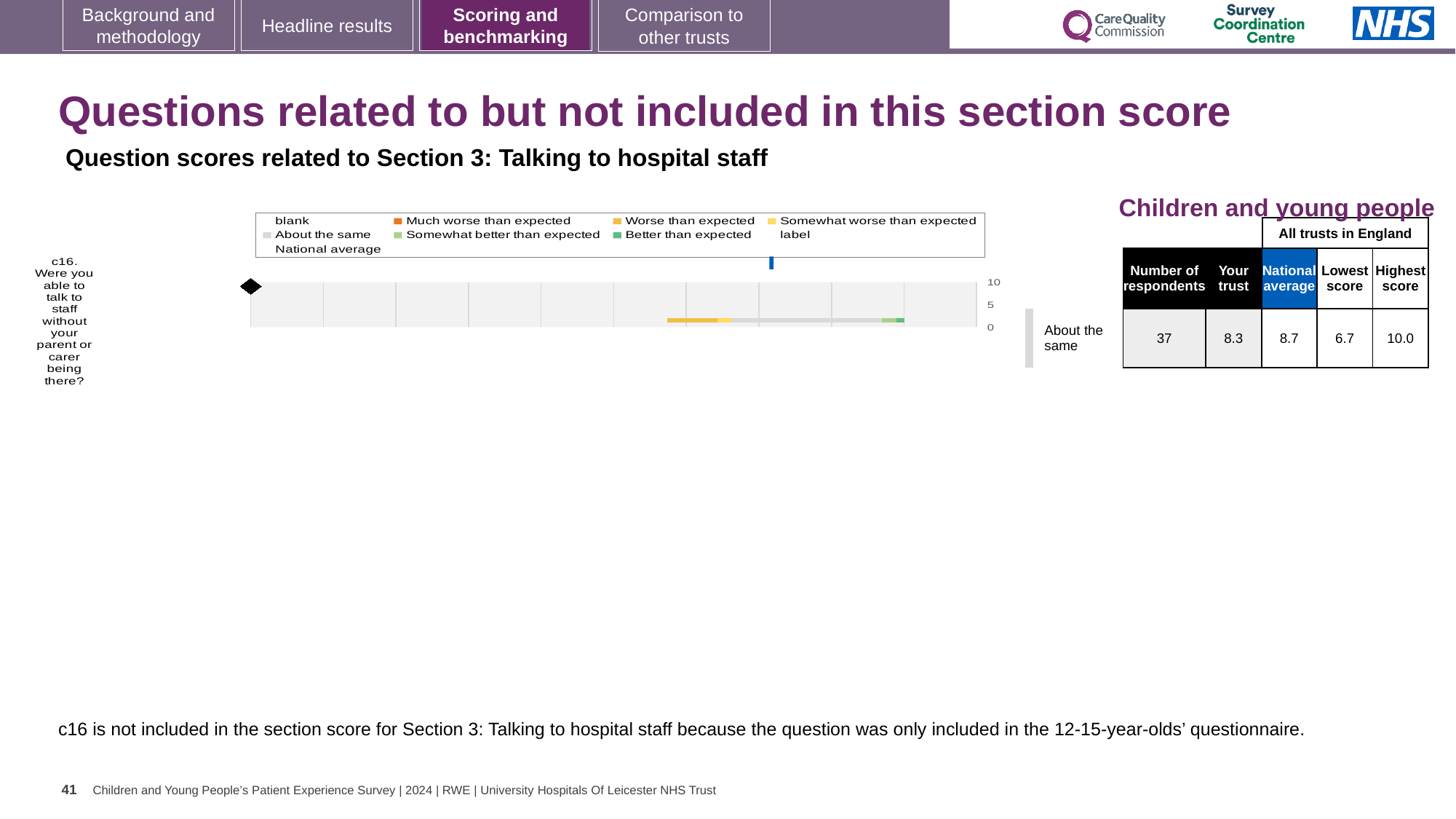
In the table next to the chart, what is the number of respondents for c16? 37 In the table next to the chart, what is the National average score for c16? 8.7 How many survey questions are plotted in the chart? 1 Which is larger for c16, the 'Your trust' score or the National average? National average How many entries does the chart legend list? 9 What kind of chart is shown on the slide? bar chart In the table next to the chart, what is the Highest score for c16? 10.0 In the table next to the chart, what is the Lowest score for c16? 6.7 Which legend entry is shown in orange? Much worse than expected In the table next to the chart, what is the 'Your trust' score for c16? 8.3 What is the difference between the National average (8.7) and the 'Your trust' score (8.3) for c16? 0.4 What rating label is shown to the right of the c16 bar? About the same